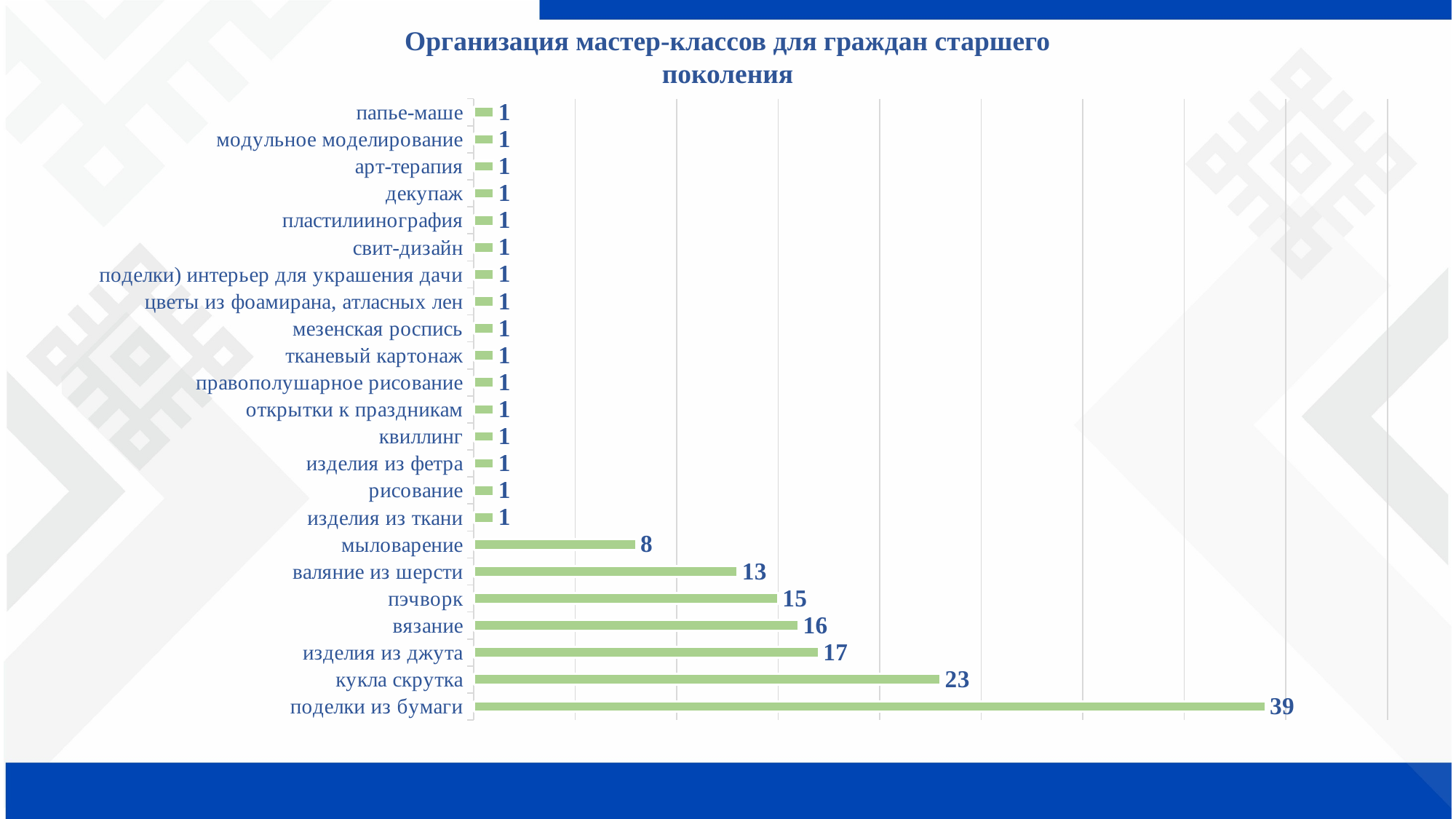
What is the difference between the values for поделки из бумаги and кукла скрутка? 16 What is the title of the chart? Организация мастер-классов для граждан старшего поколения What type of chart is shown on the slide? bar chart How many categories are shown in the chart? 23 What is the difference between the values for изделия из джута and валяние из шерсти? 4 Which is larger, the value for пэчворк or the value for мыловарение? пэчворк What is the value for валяние из шерсти? 13 Which category has the highest value? поделки из бумаги What is the value for мыловарение? 8 What is the value for вязание? 16 What is the value for кукла скрутка? 23 What is the value for поделки из бумаги? 39